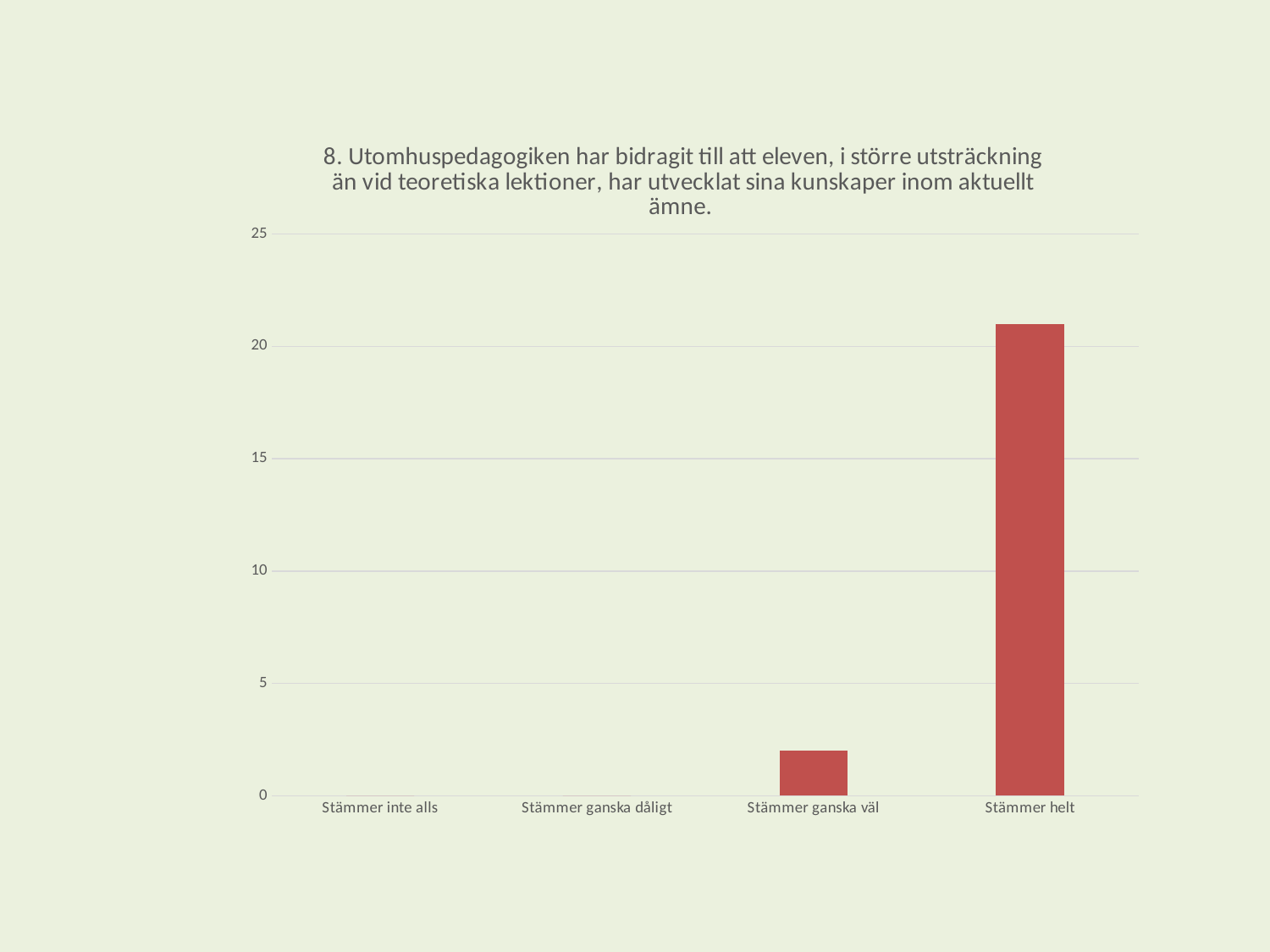
Which category has the highest value in the chart? Stämmer helt Is the value for Stämmer helt greater or less than 25? less Is the value for Stämmer ganska väl greater or less than 5? less What is the highest value shown on the vertical axis of the chart? 25 Which is larger, the value for Stämmer helt or the value for Stämmer ganska väl? Stämmer helt Do the values rise or fall moving from left to right along the x axis? rise What colour are the bars in the chart? red Which is larger, the value for Stämmer ganska väl or the value for Stämmer ganska dåligt? Stämmer ganska väl What kind of chart is shown on the slide? bar chart Is the value for Stämmer helt greater or less than 20? greater How many categories are shown on the x axis of the chart? 4